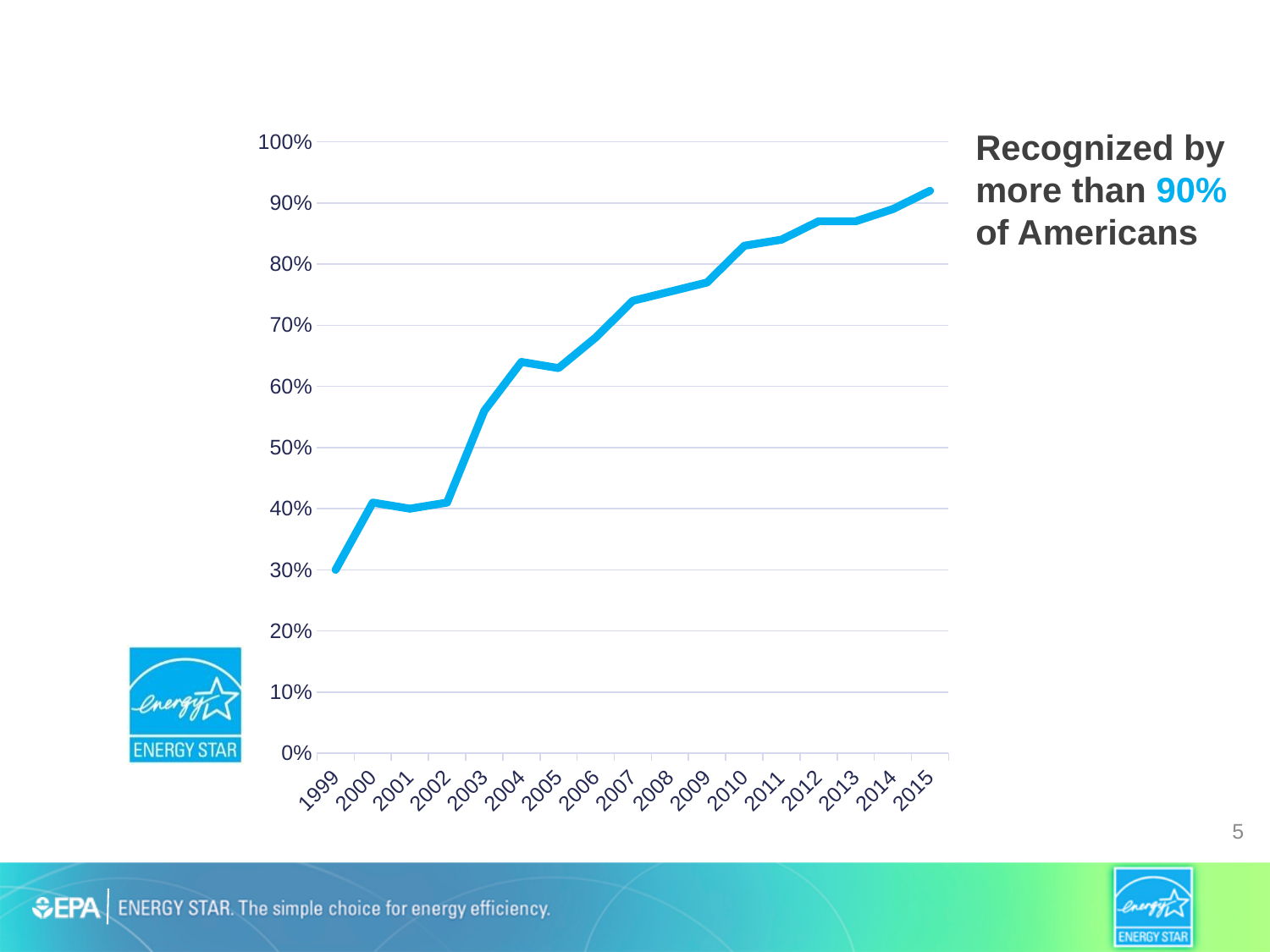
Which year has the lowest value on the chart? 1999 Is the value for 2007 greater or less than 70%? greater Is the value for 2009 greater or less than 80%? less What kind of chart is shown on the slide? line chart Is the value for 2015 greater or less than 90%? greater How many years are plotted along the x axis of the chart? 17 Which year has the highest value on the chart? 2015 What is the highest value shown on the y axis of the chart? 100% Do the values generally rise or fall from 1999 to 2015? rise Which year has the larger value, 2002 or 2003? 2003